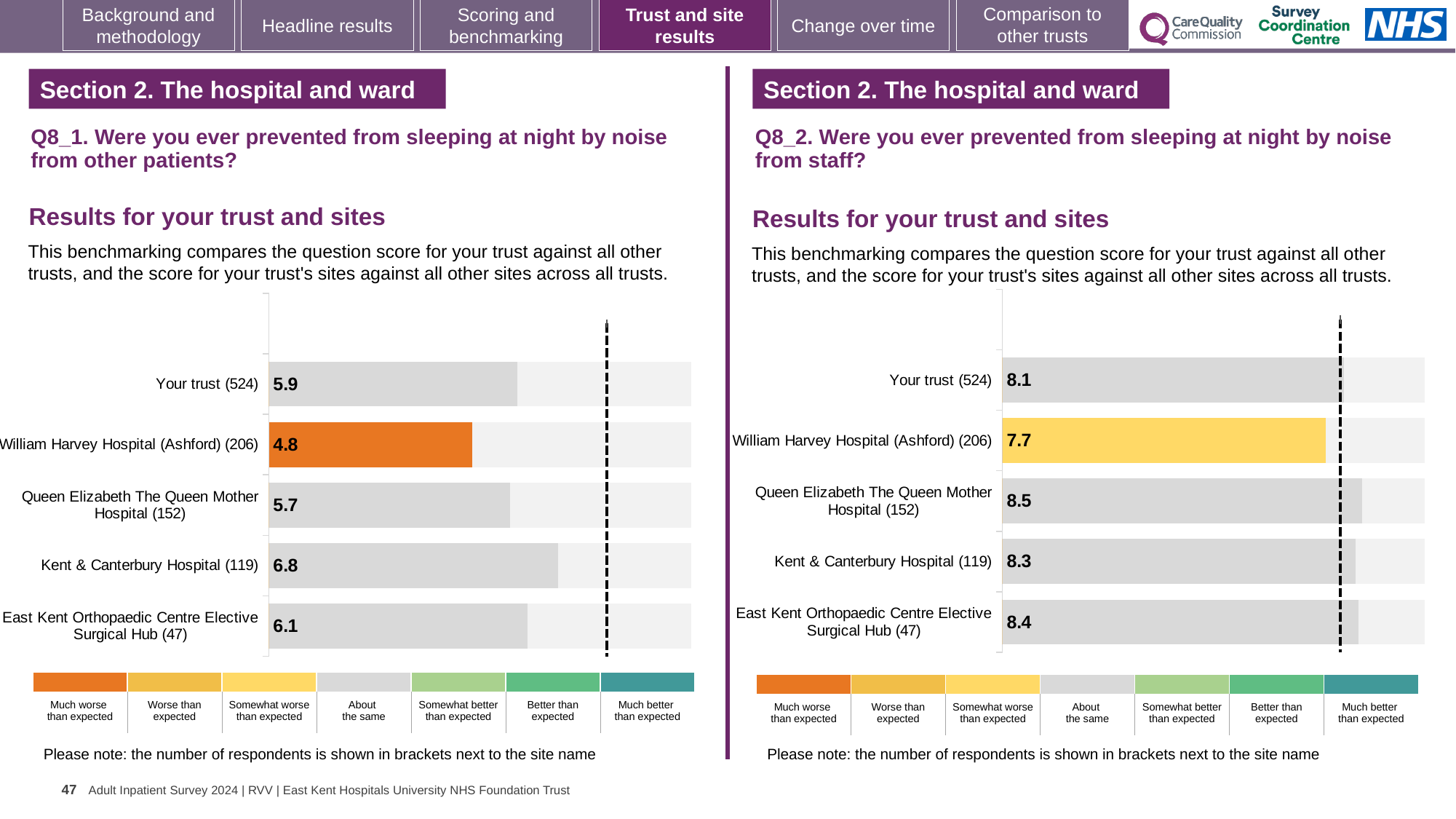
On the Q8_1 chart (left), what is the difference between the scores for Kent & Canterbury Hospital (119) and William Harvey Hospital (Ashford) (206)? 2.0 On the Q8_2 chart (right), what is the score for Queen Elizabeth The Queen Mother Hospital (152)? 8.5 On the Q8_2 chart (right), which is larger: the score for Your trust (524) or for East Kent Orthopaedic Centre Elective Surgical Hub (47)? East Kent Orthopaedic Centre Elective Surgical Hub (47) On the Q8_1 chart (left), which site has the highest score? Kent & Canterbury Hospital (119) On the Q8_1 chart (left), what is the score for Your trust (524)? 5.9 On the Q8_1 chart (left), what benchmark category does the orange colour of the William Harvey Hospital bar indicate? Much worse than expected On the Q8_2 chart (right), which site has the lowest score? William Harvey Hospital (Ashford) (206) What kind of chart is used on the Q8_1 chart (left)? Bar chart On the Q8_1 chart (left), how many bars are plotted? 5 On the Q8_1 chart (left), which site has the lowest score? William Harvey Hospital (Ashford) (206) On the Q8_2 chart (right), what is the difference between the scores for Your trust (524) and William Harvey Hospital (Ashford) (206)? 0.4 On the Q8_2 chart (right), what benchmark category does the yellow colour of the William Harvey Hospital bar indicate? Somewhat worse than expected